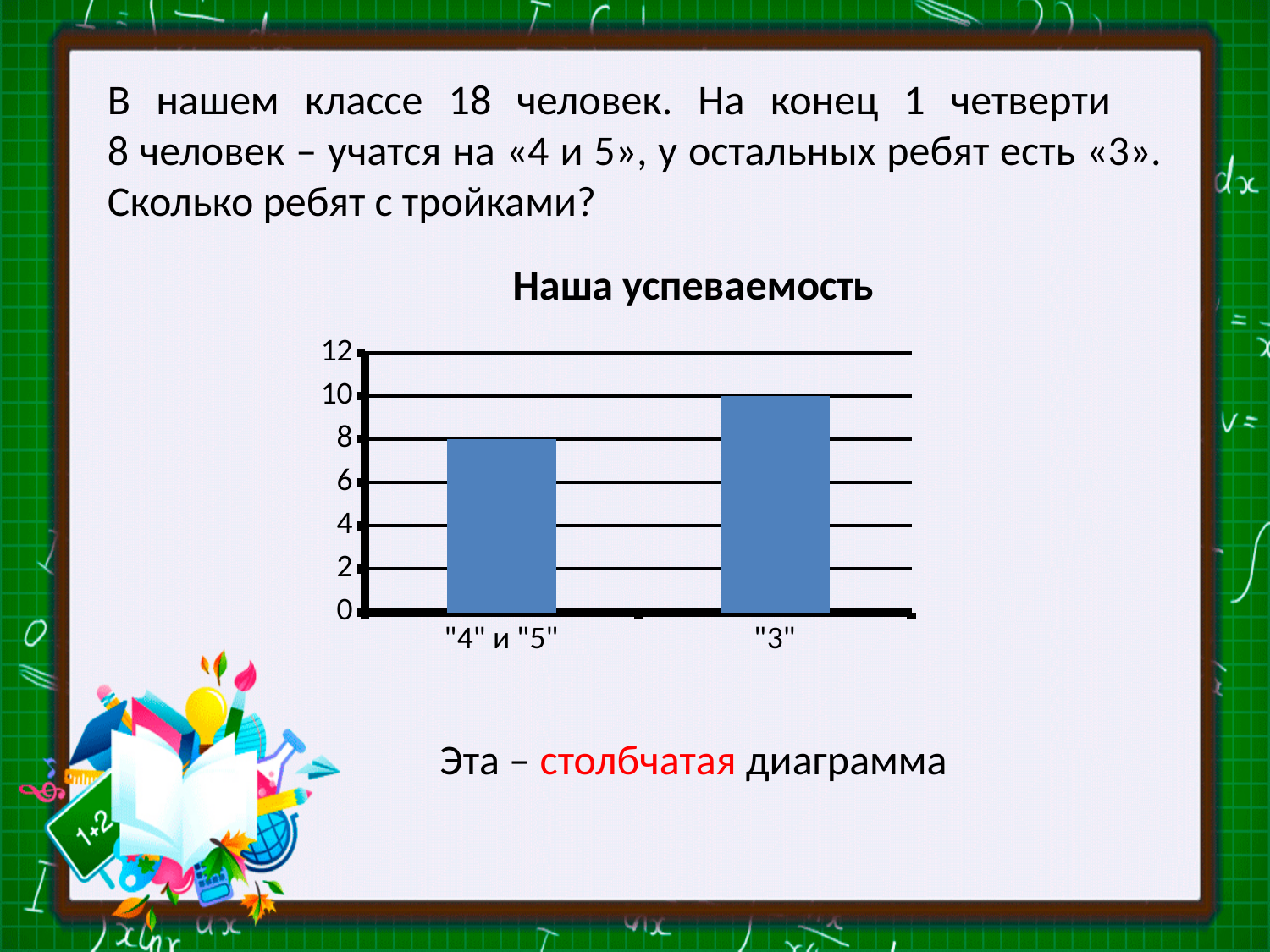
What is the title of the chart? Наша успеваемость What is the highest value shown on the vertical axis of the chart? 12 Which is larger: the value for "3" or the value for "4" и "5"? "3" Which category has the highest value? "3" Is the value for "3" greater or less than 6? greater How many categories are shown on the x axis of the chart? 2 Is the value for "4" и "5" greater or less than 12? less What is the difference between the value for "3" and the value for "4" и "5"? 2 Which category has the lowest value? "4" и "5" What is the value for "3" in the chart? 10 What is the value for "4" и "5" in the chart? 8 What kind of chart is shown on the slide? bar chart